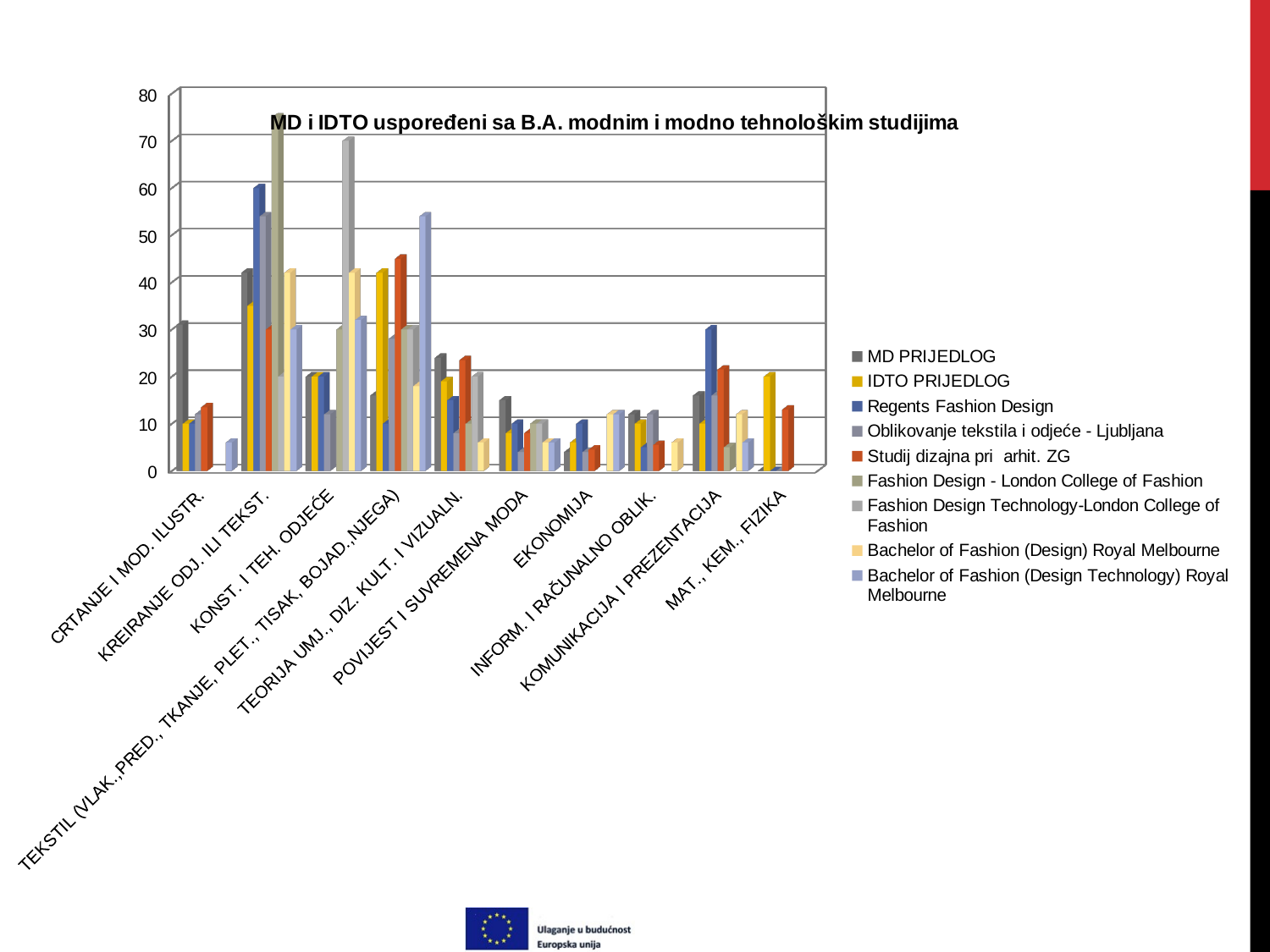
Is the value for Regents Fashion Design in the MAT., KEM., FIZIKA category greater or less than 10? less Which category contains the tallest bar in the chart? KREIRANJE ODJ. ILI TEKST. What kind of chart is shown on the slide? bar chart How many series does the legend list? 9 Which series has the highest value in the KREIRANJE ODJ. ILI TEKST. category? Fashion Design - London College of Fashion In the TEKSTIL category, which is larger: Oblikovanje tekstila i odjeće - Ljubljana or Bachelor of Fashion (Design Technology) Royal Melbourne? Bachelor of Fashion (Design Technology) Royal Melbourne In the CRTANJE I MOD. ILUSTR. category, which is larger: MD PRIJEDLOG or IDTO PRIJEDLOG? MD PRIJEDLOG Is the value for Studij dizajna pri arhit. ZG in the TEKSTIL category greater or less than 40? greater Is the value for Fashion Design - London College of Fashion in the KREIRANJE ODJ. ILI TEKST. category greater or less than 70? greater How many categories are shown on the x axis? 10 What is the title of the chart? MD i IDTO uspoređeni sa B.A. modnim i modno tehnološkim studijima